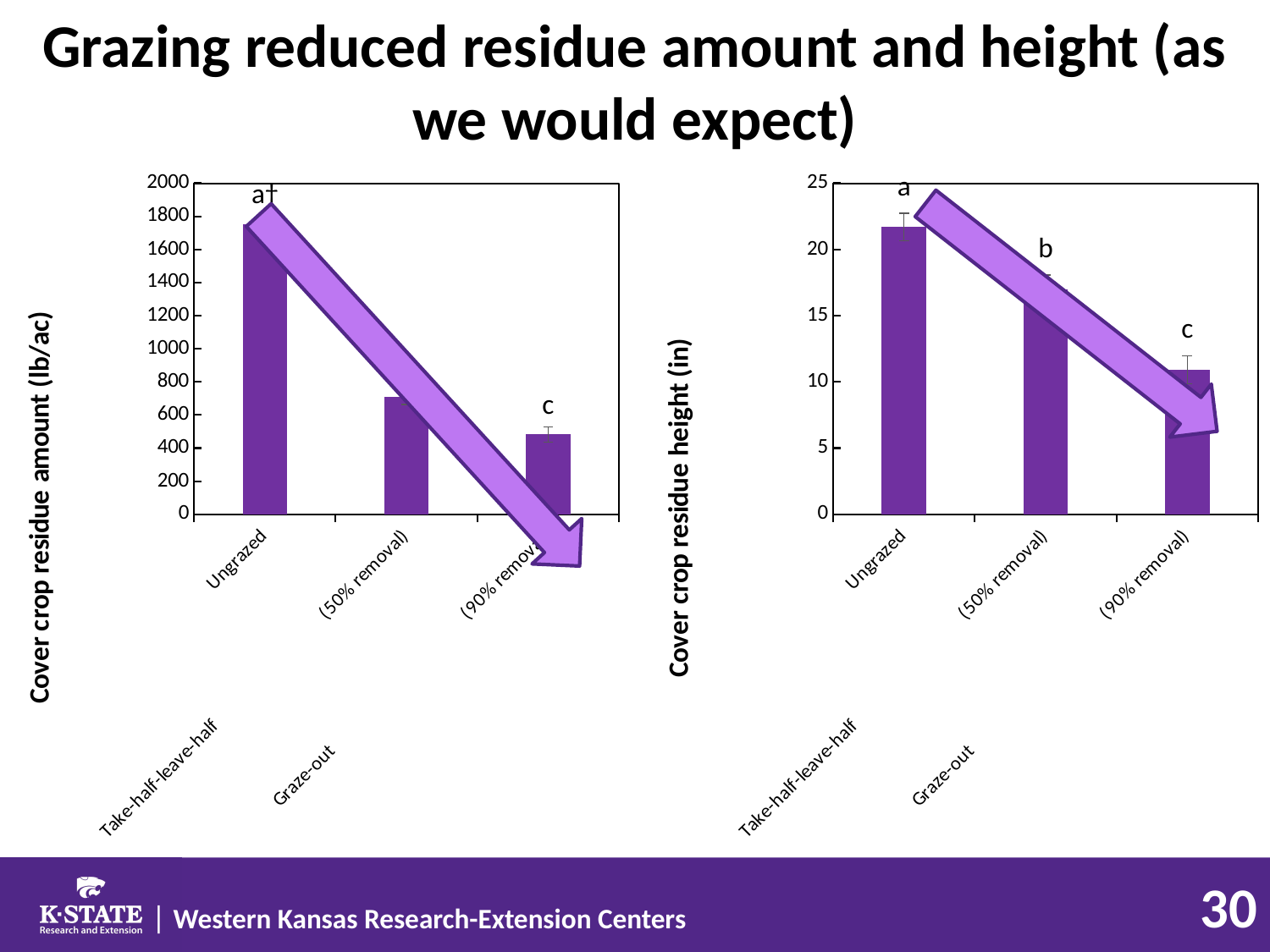
In the right chart (Cover crop residue height), which category has the highest value? Ungrazed In the right chart (Cover crop residue height), how many categories are shown on the x axis? 3 In the right chart (Cover crop residue height), is the value for 90% removal greater or less than 15? less What kind of chart is the right chart (Cover crop residue height)? bar chart In the left chart (Cover crop residue amount), is the value for Ungrazed greater or less than 1600? greater In the left chart (Cover crop residue amount), which category has the highest value? Ungrazed In the left chart (Cover crop residue amount), do the values rise or fall from left to right along the x axis? fall In the left chart (Cover crop residue amount), how many bars are plotted? 3 In the left chart (Cover crop residue amount), which category has the lowest value? 90% removal In the right chart (Cover crop residue height), which is larger, the value for Ungrazed or the value for 50% removal? Ungrazed In the right chart (Cover crop residue height), which category has the lowest value? 90% removal What kind of chart is the left chart (Cover crop residue amount)? bar chart